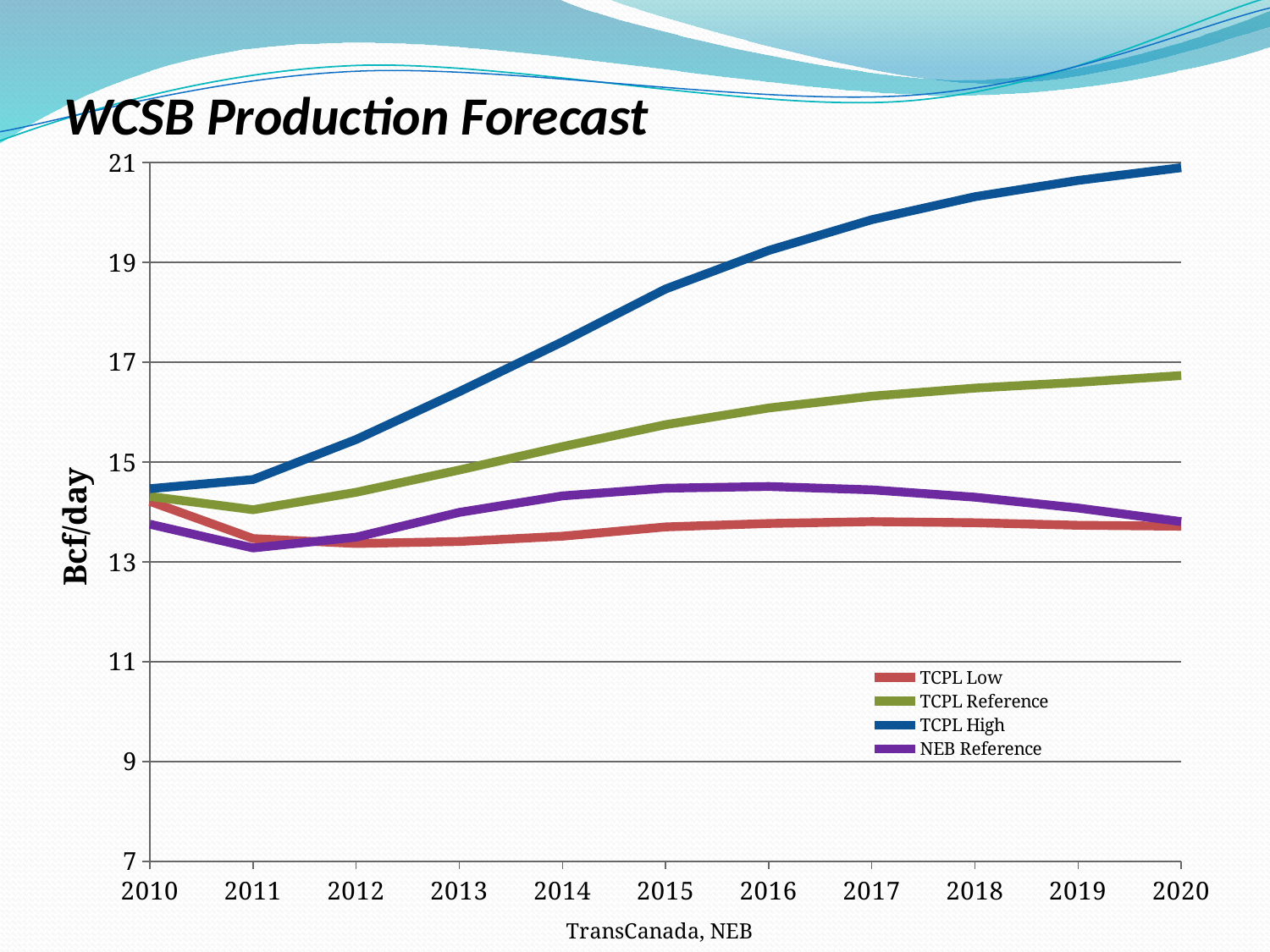
Is the value for TCPL High in 2020 greater or less than 19? greater What is the label on the y axis? Bcf/day Is the value for TCPL Low in 2020 greater or less than 15? less Which series has the highest value in 2020? TCPL High Is the value for TCPL Reference in 2020 greater or less than 15? greater What kind of chart is shown on the slide? line chart What is the title of the chart? WCSB Production Forecast Which series has the lowest value in 2016? TCPL Low In 2015, which is larger: TCPL High or TCPL Reference? TCPL High Does the TCPL High series rise or fall from 2010 to 2020? rise How many years are shown along the x axis? 11 How many series does the legend list? 4